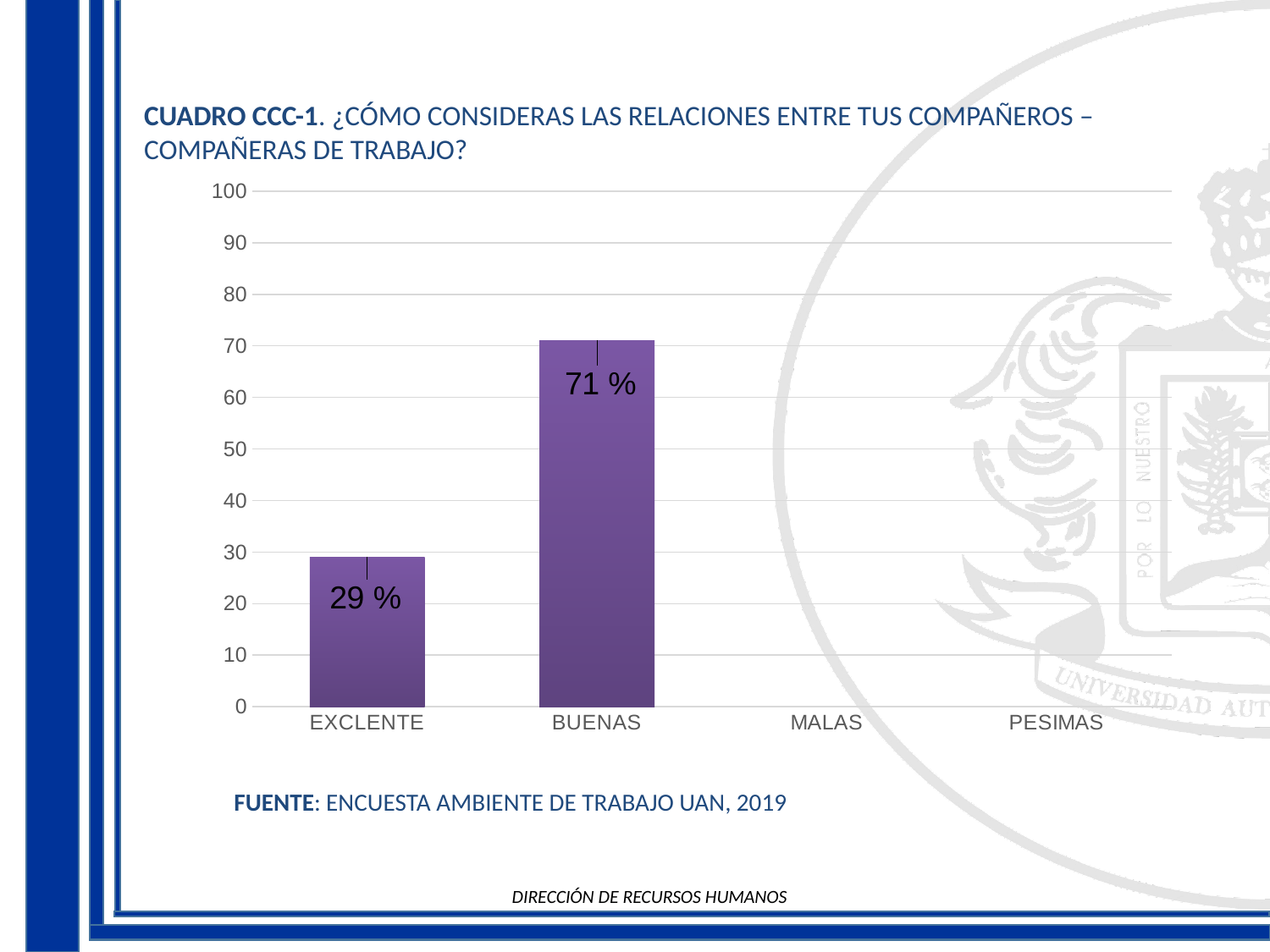
What is the value for EXCLENTE? 29 % Is the value for BUENAS greater or less than 60? greater Is the value for EXCLENTE greater or less than 40? less What is the highest value shown on the y axis? 100 What kind of chart is shown on the slide? bar chart What is the difference between the values for BUENAS and EXCLENTE? 42 % Which is larger, the value for EXCLENTE or the value for BUENAS? BUENAS How many categories are shown on the x axis? 4 What is the total of the values for EXCLENTE and BUENAS? 100 % What is the source cited below the chart? ENCUESTA AMBIENTE DE TRABAJO UAN, 2019 What is the value for BUENAS? 71 % Which category has the highest value? BUENAS